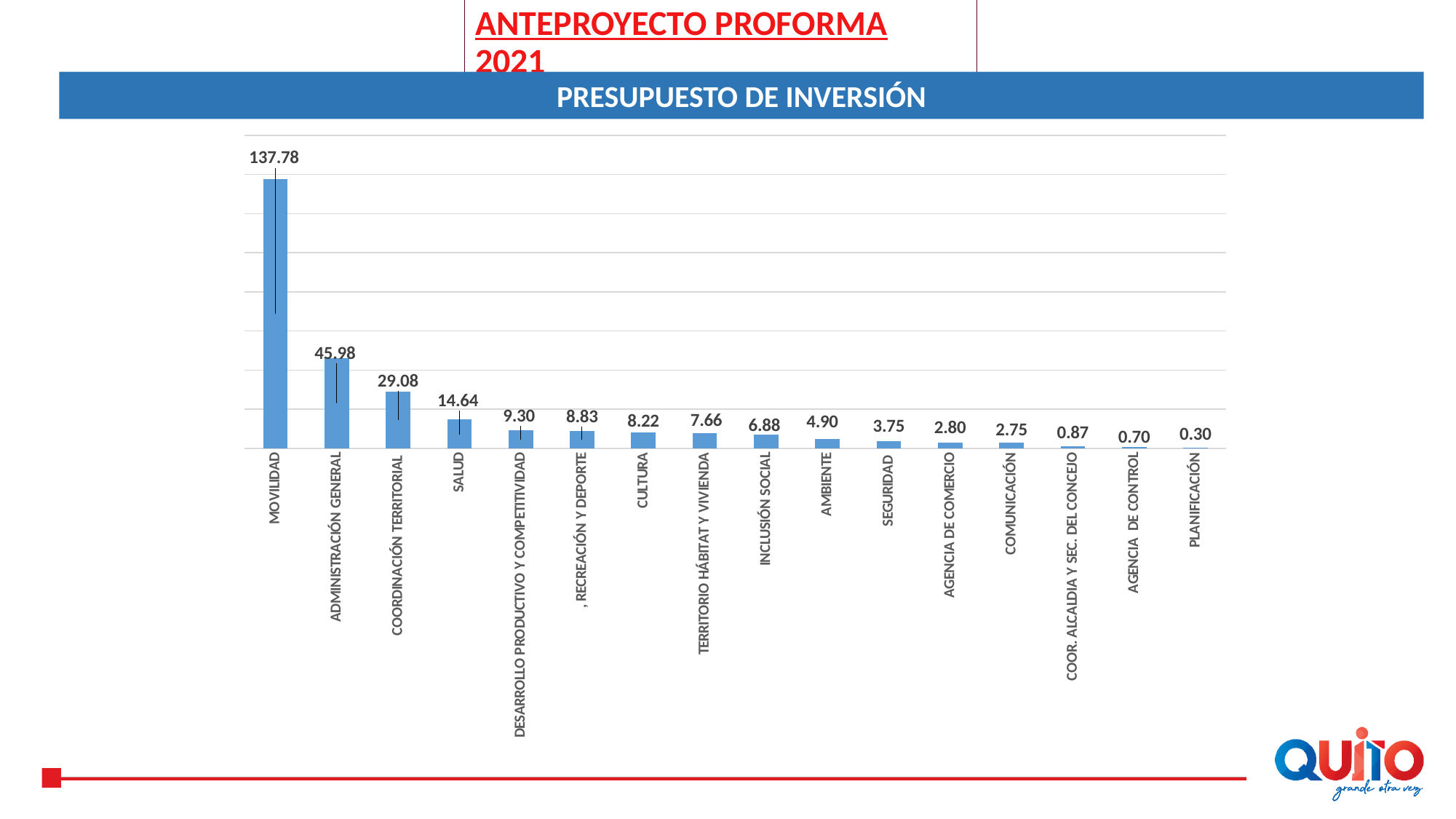
What is the value for MOVILIDAD? 137.78 What is the difference between the values for MOVILIDAD and ADMINISTRACIÓN GENERAL? 91.80 What is the value for SEGURIDAD? 3.75 Which category has the highest value? MOVILIDAD What is the value for CULTURA? 8.22 Do the values rise or fall from left to right along the x axis? fall Which category has the lowest value? PLANIFICACIÓN What is the difference between the values for COORDINACIÓN TERRITORIAL and SALUD? 14.44 Which is larger, the value for AMBIENTE or the value for INCLUSIÓN SOCIAL? INCLUSIÓN SOCIAL What kind of chart is shown on the slide? bar chart How many categories are shown on the x axis? 16 What is the value for SALUD? 14.64